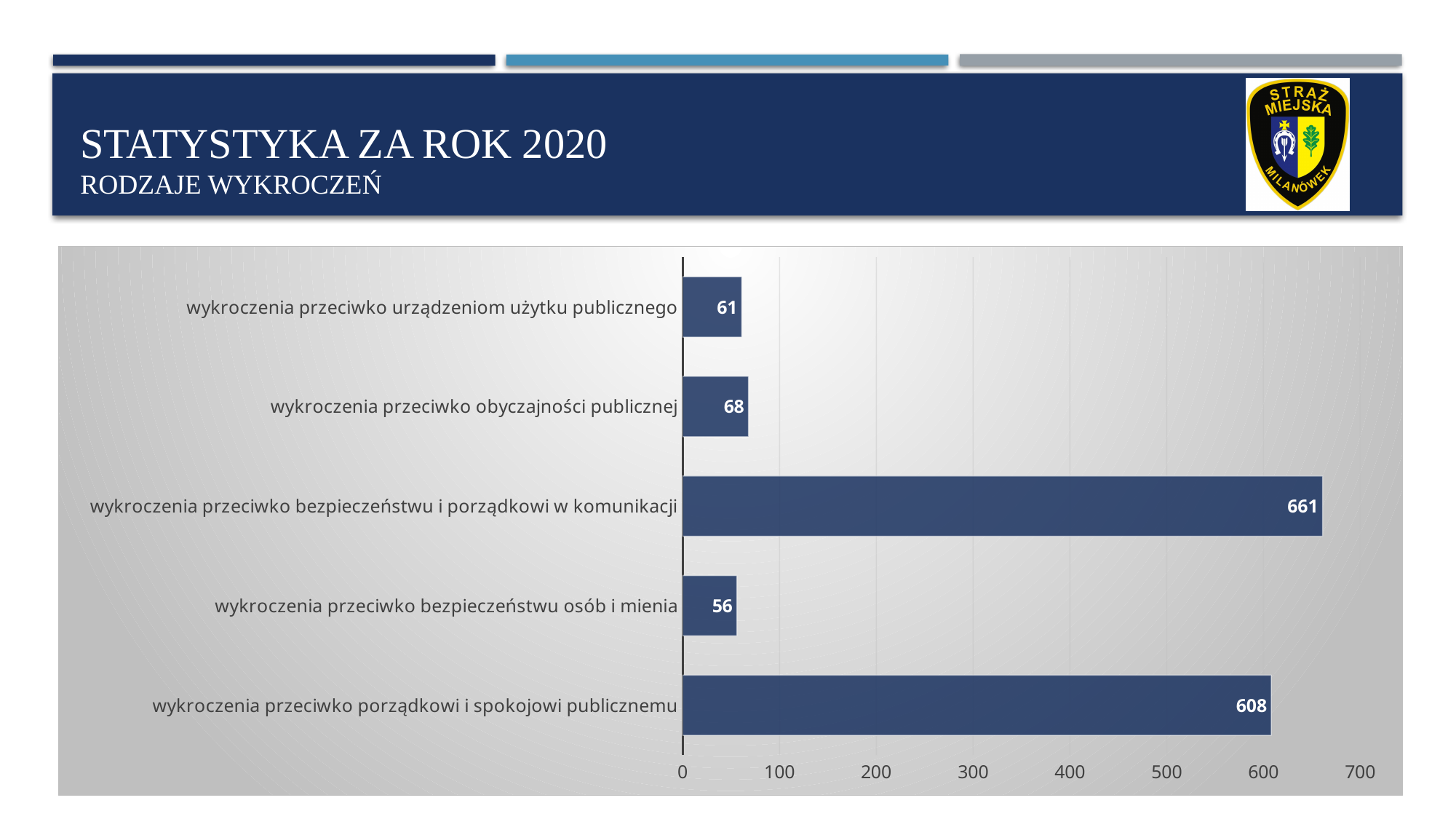
What is the title of the slide? STATYSTYKA ZA ROK 2020 RODZAJE WYKROCZEŃ What is the difference between the values for 'wykroczenia przeciwko bezpieczeństwu i porządkowi w komunikacji' and 'wykroczenia przeciwko porządkowi i spokojowi publicznemu'? 53 What is the value for 'wykroczenia przeciwko porządkowi i spokojowi publicznemu'? 608 Which category has the lowest value? wykroczenia przeciwko bezpieczeństwu osób i mienia What is the value for 'wykroczenia przeciwko obyczajności publicznej'? 68 What is the value for 'wykroczenia przeciwko bezpieczeństwu i porządkowi w komunikacji'? 661 Which is larger: the value for 'wykroczenia przeciwko obyczajności publicznej' or 'wykroczenia przeciwko urządzeniom użytku publicznego'? wykroczenia przeciwko obyczajności publicznej What is the value for 'wykroczenia przeciwko urządzeniom użytku publicznego'? 61 What kind of chart is shown on the slide? bar chart How many categories are shown in the chart? 5 Which category has the highest value? wykroczenia przeciwko bezpieczeństwu i porządkowi w komunikacji Is the value for 'wykroczenia przeciwko porządkowi i spokojowi publicznemu' greater or less than 500? greater